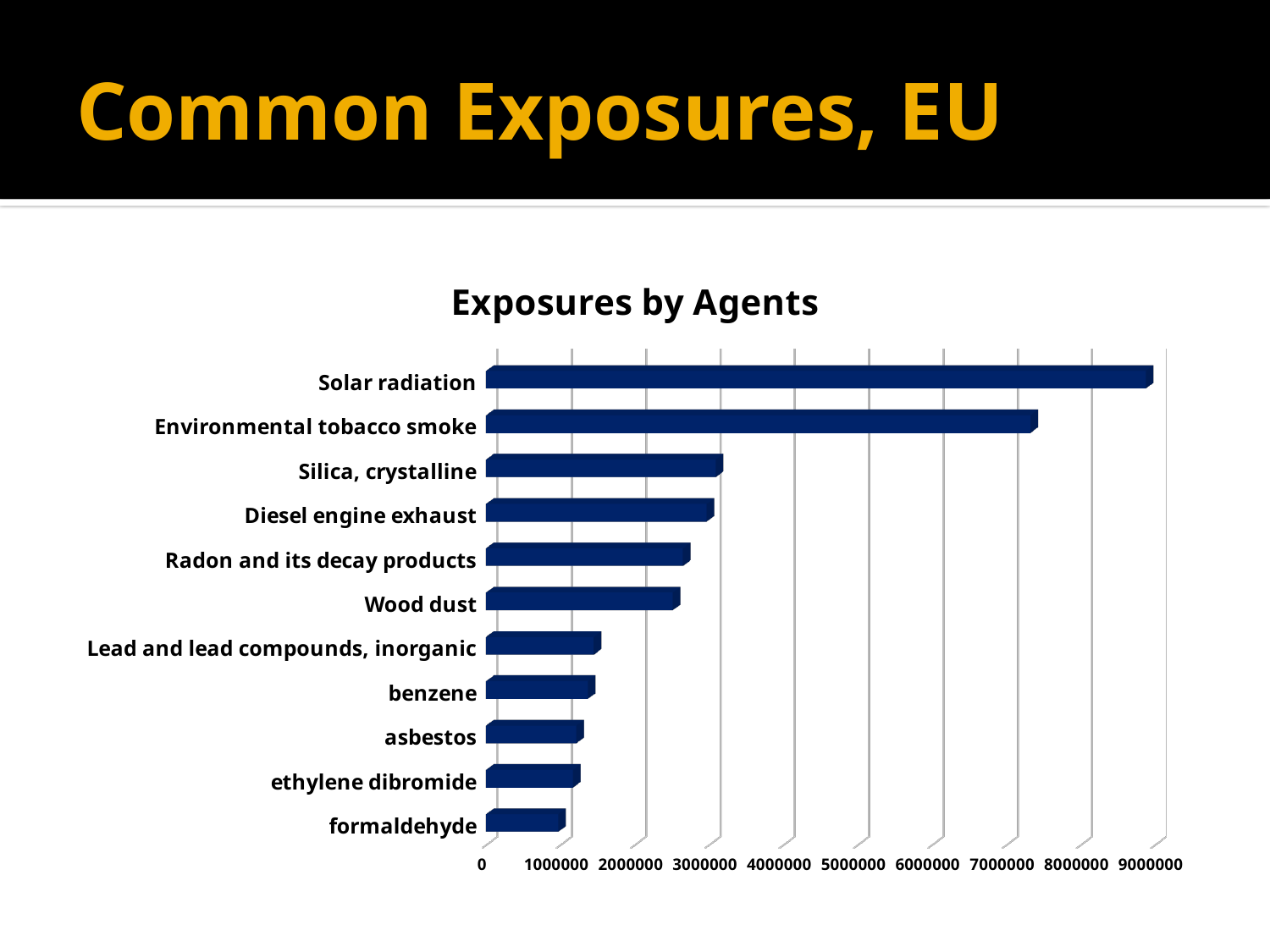
Is the value for Wood dust greater or less than 2000000? greater Which agent has the lowest exposure value? formaldehyde Is the value for Radon and its decay products greater or less than 3000000? less How many agents (categories) are plotted in the chart? 11 Is the value for Lead and lead compounds, inorganic greater or less than 2000000? less Which agent has the highest exposure value? Solar radiation Which has a larger value, Solar radiation or Environmental tobacco smoke? Solar radiation What type of chart is shown on the slide? bar chart What is the title of the chart? Exposures by Agents Which has a larger value, Wood dust or benzene? Wood dust